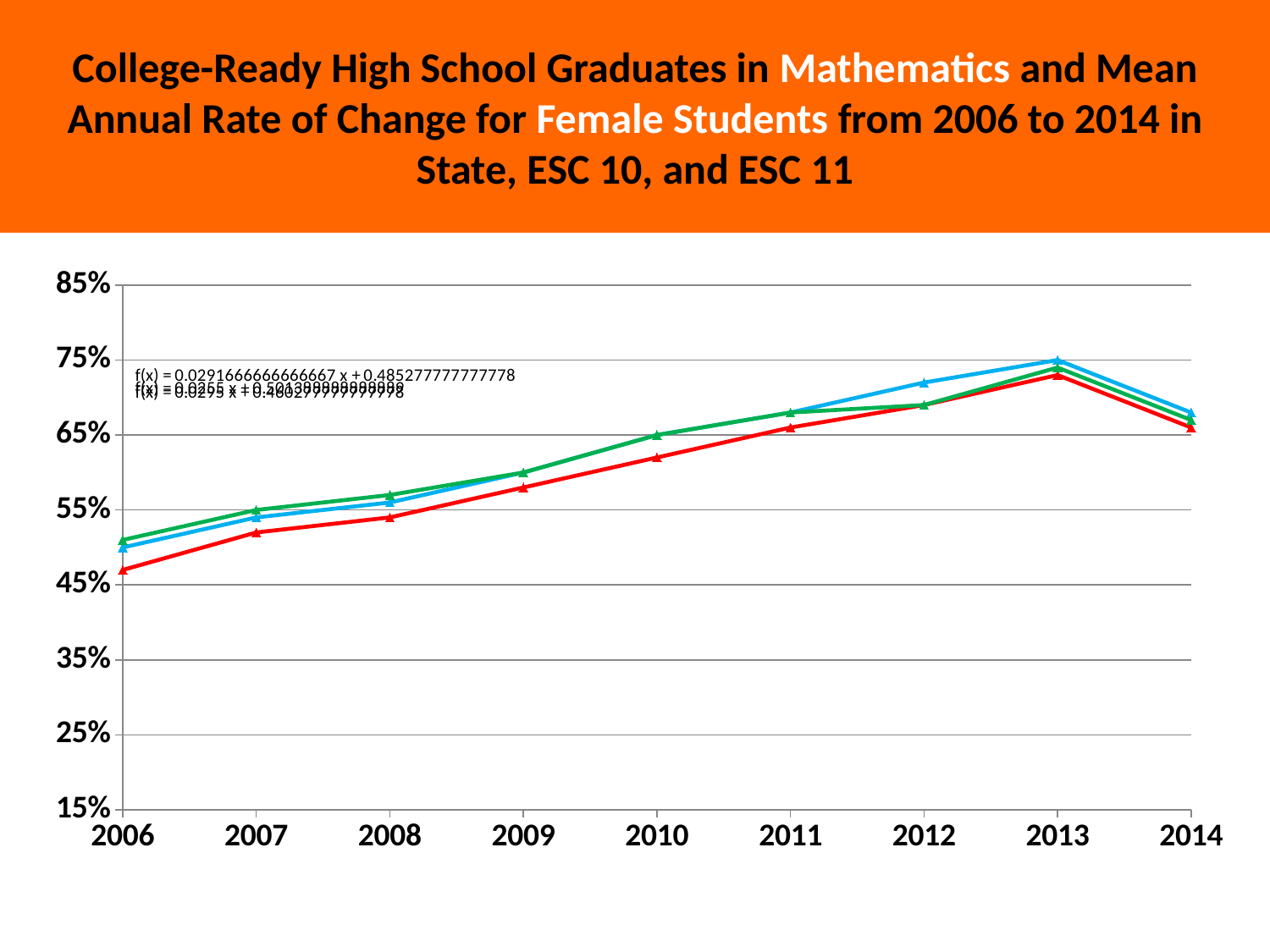
In 2012, which line has the higher value, the red line or the blue line? the blue line Is the value of the red line in 2010 greater or less than 65%? less Do the values of the red line rise or fall from 2006 to 2013? rise How many lines are plotted on the chart? 3 How many years are plotted along the x axis? 9 Is the value of the red line in 2013 greater or less than 65%? greater Is the value of the green line in 2006 greater or less than 55%? less What kind of chart is shown on the slide? line chart In which year does the red line reach its highest value? 2013 Which subject is named in the chart title? Mathematics Do the values of the green line rise or fall from 2013 to 2014? fall In which year does the blue line have its lowest value? 2006